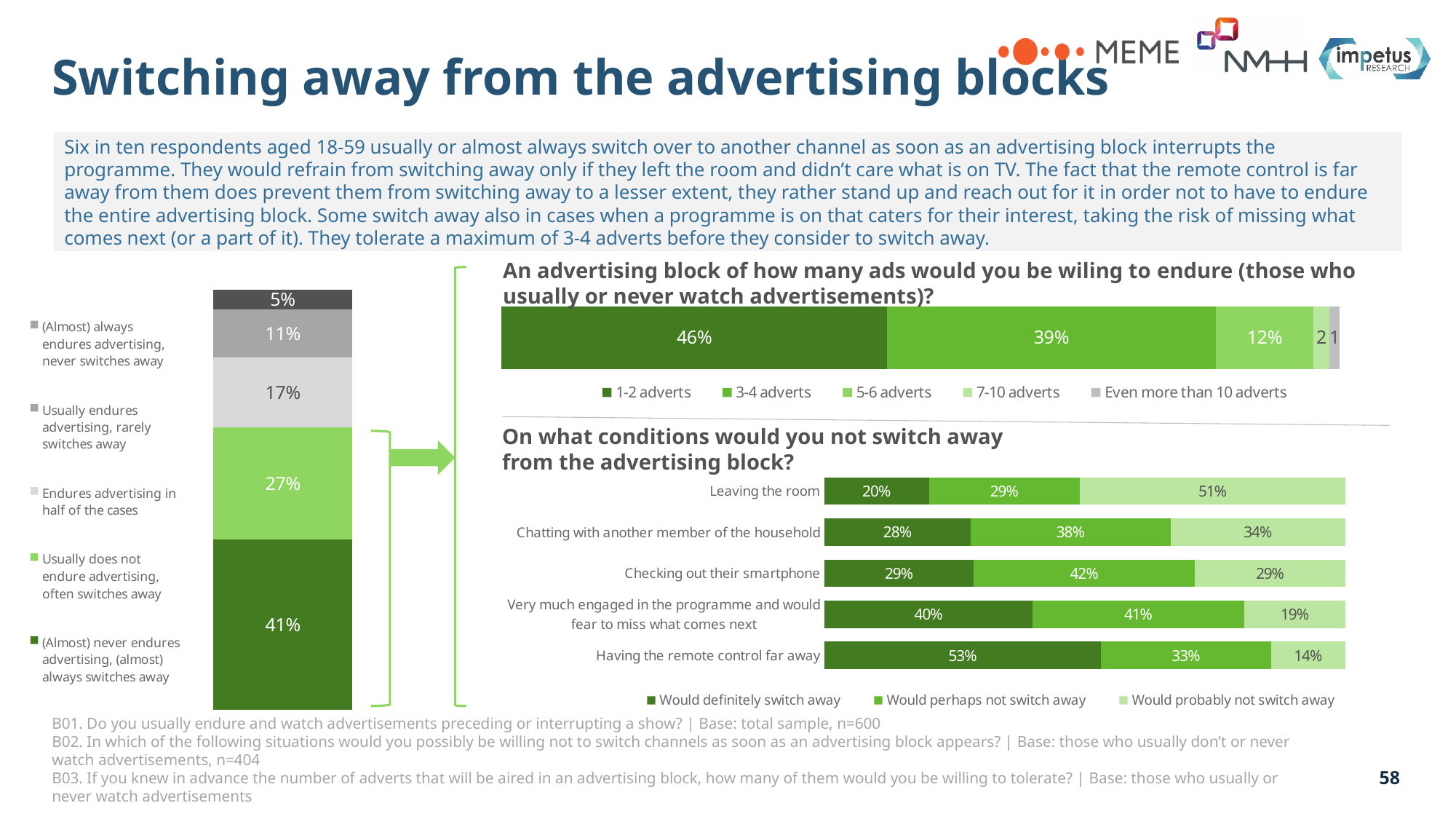
In the chart titled 'An advertising block of how many ads would you be wiling to endure', how many series does the legend list? 5 In the chart titled 'An advertising block of how many ads would you be wiling to endure', what percentage would endure 1-2 adverts? 46% In the stacked bar chart on the left of the slide, what is the combined share of respondents who usually do not endure advertising and those who (almost) never endure advertising? 68% In the chart titled 'On what conditions would you not switch away from the advertising block?', what percentage would definitely switch away when having the remote control far away? 53% In the chart titled 'On what conditions would you not switch away from the advertising block?', what is the difference between the 'Would perhaps not switch away' share for checking out their smartphone and for leaving the room? 13% In the stacked bar chart on the left of the slide, which segment is the smallest? (Almost) always endures advertising, never switches away In the stacked bar chart on the left of the slide, what percentage of respondents (almost) never endure advertising and (almost) always switch away? 41% In the chart titled 'On what conditions would you not switch away from the advertising block?', what percentage would probably not switch away when leaving the room? 51% In the chart titled 'On what conditions would you not switch away from the advertising block?', how many conditions are listed? 5 In the chart titled 'An advertising block of how many ads would you be wiling to endure', what percentage would endure 5-6 adverts? 12% In the stacked bar chart on the left of the slide, what percentage of respondents endure advertising in half of the cases? 17% In the chart titled 'On what conditions would you not switch away from the advertising block?', which condition has the highest share of 'Would definitely switch away'? Having the remote control far away